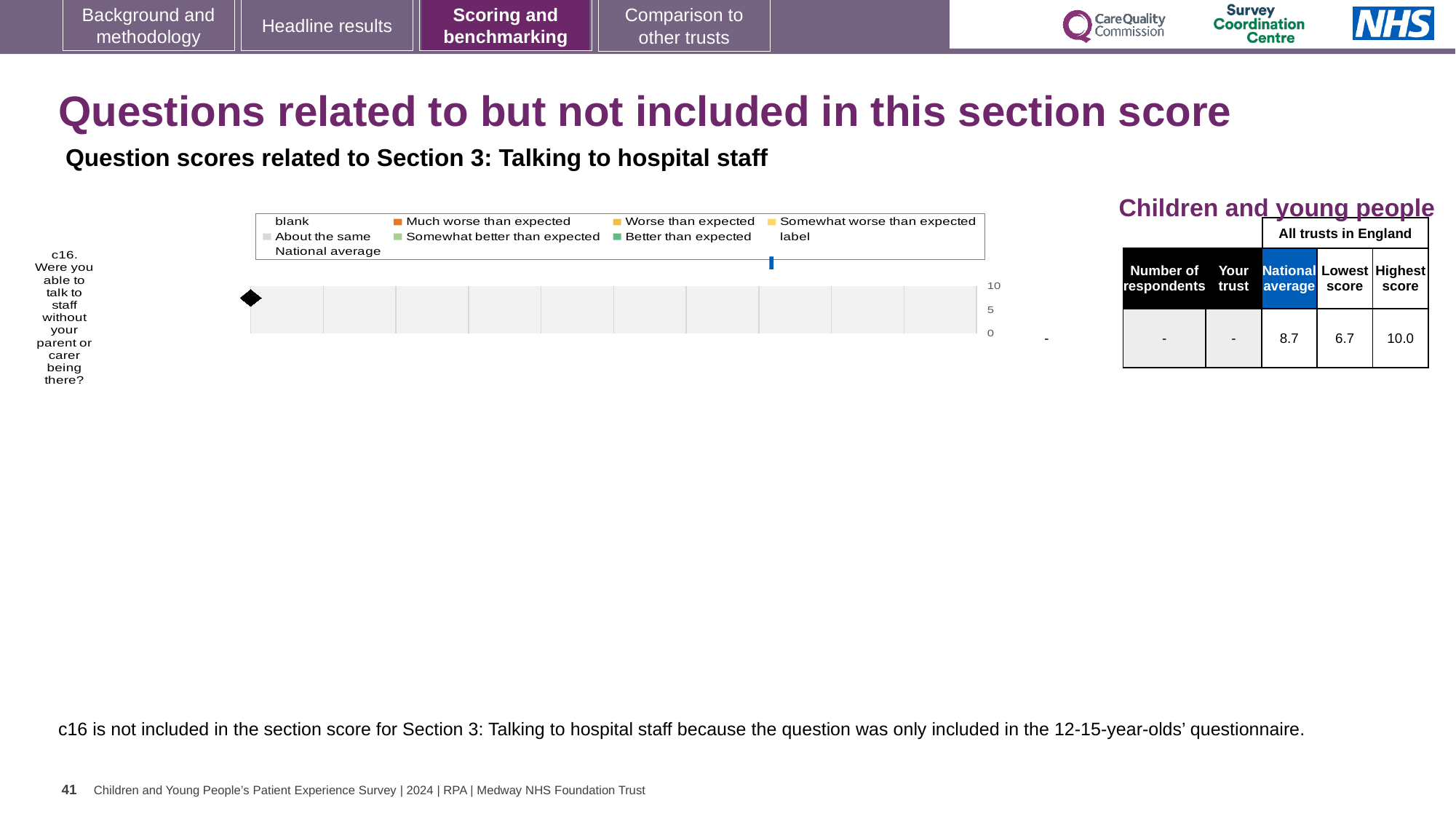
In the table to the right of the chart, what value is shown for Your trust for c16? - In the table to the right of the chart, which is larger for c16: the National average or the Lowest score? National average In the table to the right of the chart, what is the Lowest score among all trusts in England for c16? 6.7 In the table to the right of the chart, what is the Highest score among all trusts in England for c16? 10.0 In the table to the right of the chart, is the National average for c16 greater or less than 5? greater Which question is shown as the category label on the chart? c16. Were you able to talk to staff without your parent or carer being there? In the table to the right of the chart, what is the difference between the Highest score and the Lowest score for c16? 3.3 In the table to the right of the chart, what is the National average score for c16? 8.7 How many question categories are plotted on the chart? 1 What is the highest value shown on the chart's numeric axis? 10